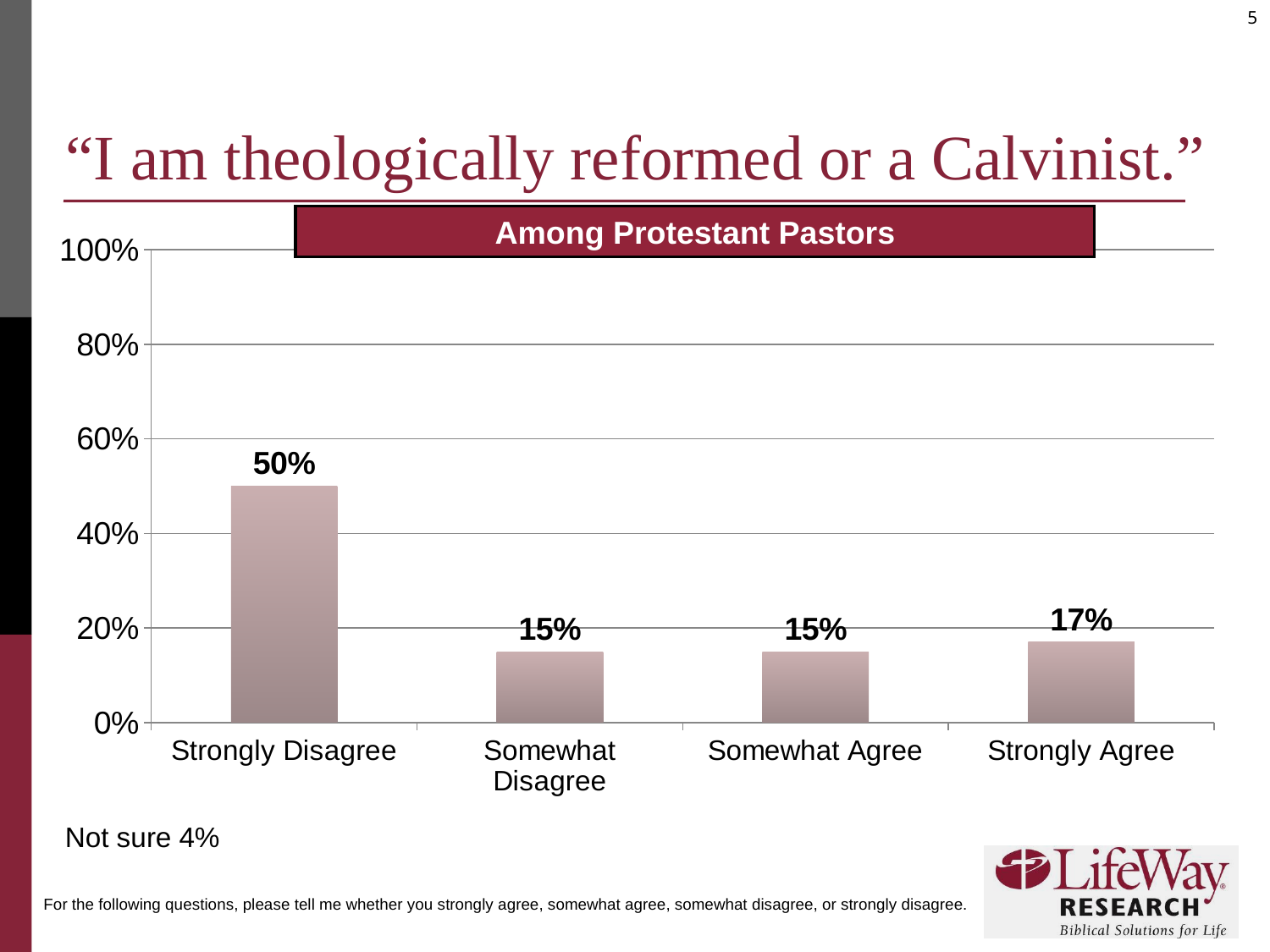
What is the difference between the Strongly Disagree value and the Strongly Agree value? 33% What percentage of pastors answered "Not sure" according to the slide? 4% Is the value for Somewhat Agree greater or less than 20%? less What kind of chart is shown on the slide? Bar chart How many response categories are plotted on the chart? 4 What is the value shown for Somewhat Disagree? 15% What percentage of Protestant pastors strongly disagree with the statement "I am theologically reformed or a Calvinist"? 50% Which group of respondents does the chart cover, according to the label above the chart? Protestant Pastors Is the value for Strongly Disagree greater or less than 40%? greater What is the value shown for Strongly Agree? 17% Which response category has the highest value? Strongly Disagree Which is larger, the value for Strongly Agree or the value for Somewhat Agree? Strongly Agree